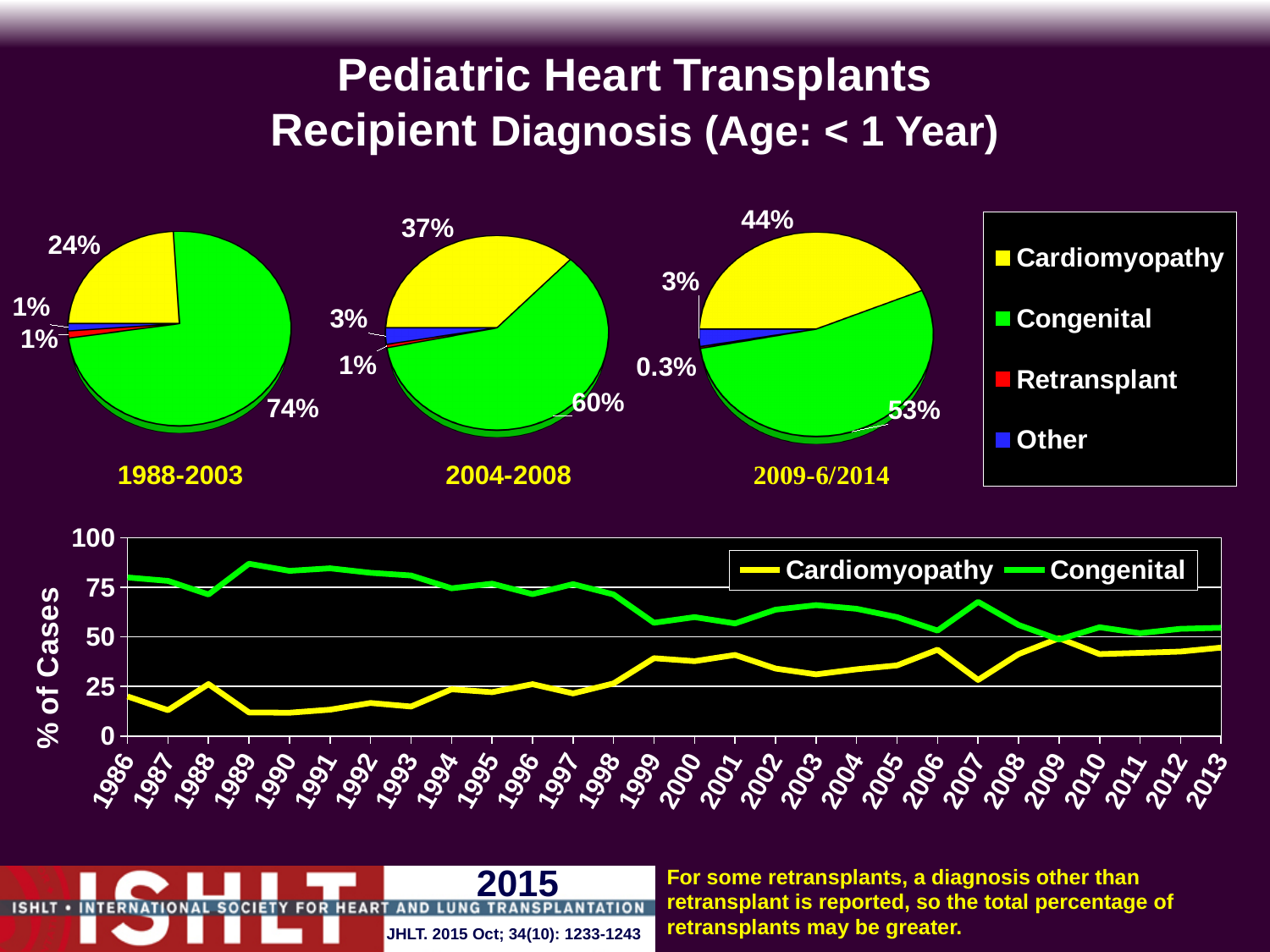
In the 2004-2008 pie chart, what percentage is shown for Cardiomyopathy? 37% How many diagnosis categories does the pie chart legend list? 4 In the 2009-6/2014 pie chart, which diagnosis has the largest share? Congenital In the 2009-6/2014 pie chart, what percentage is shown for Retransplant? 0.3% In the 1988-2003 pie chart, what percentage is shown for Congenital? 74% In the bottom line chart, is the Congenital value for 1989 greater or less than 75? greater In the 2009-6/2014 pie chart, what is the difference between the Congenital and Cardiomyopathy percentages? 9% Comparing the Cardiomyopathy share in the 1988-2003 pie chart with that in the 2009-6/2014 pie chart, which is larger? 2009-6/2014 In the bottom line chart, is the Cardiomyopathy value for 2007 greater or less than 50? less What type of chart is the bottom chart showing % of Cases by year? Line chart In the bottom line chart, does the Cardiomyopathy line generally rise or fall from 1986 to 2013? Rise In the 2004-2008 pie chart, which diagnosis has the smallest share? Retransplant